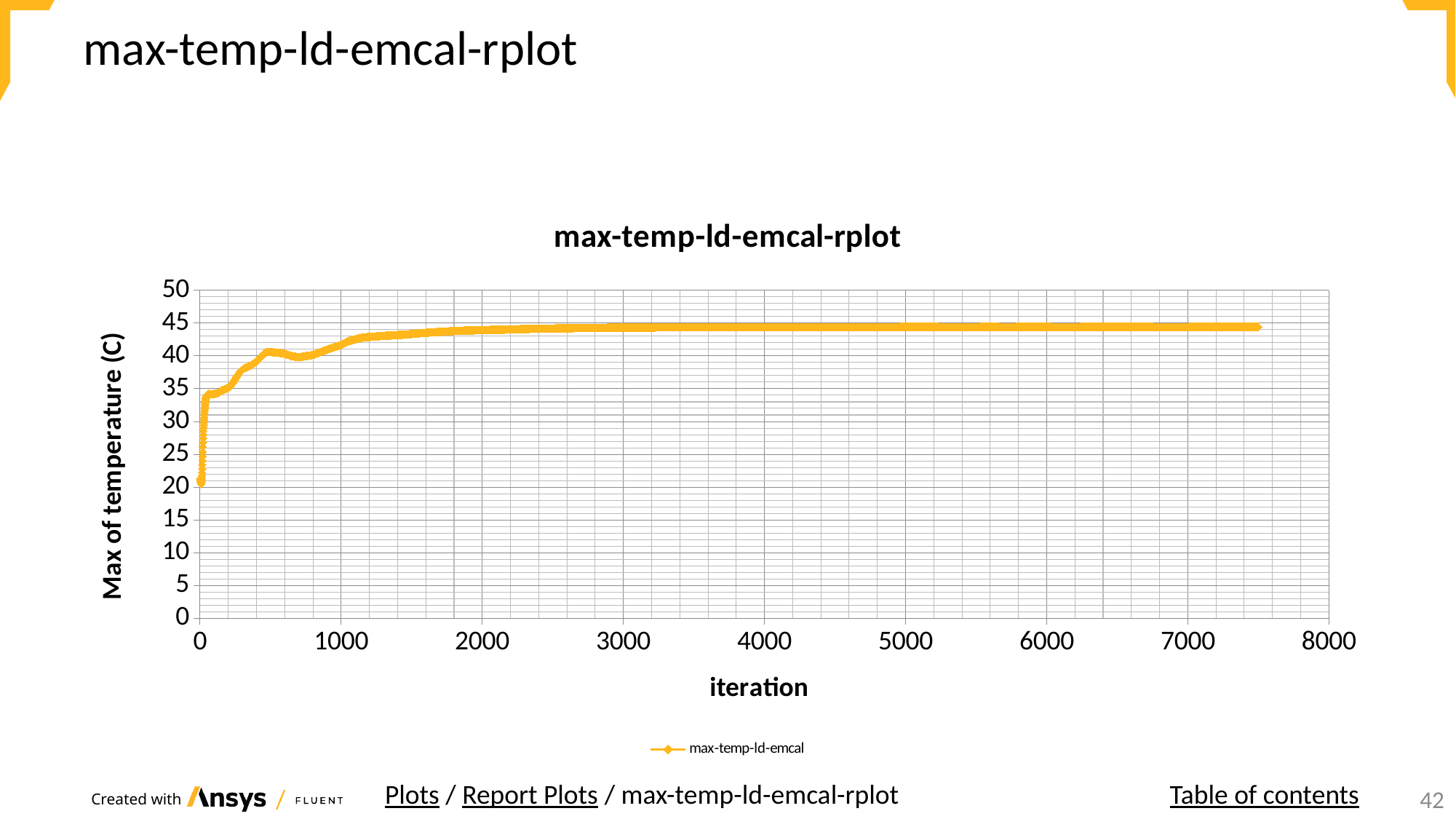
What kind of chart is shown on the slide? line chart What is the label of the y axis? Max of temperature (C) How many series does the legend list? 1 Is the value for max-temp-ld-emcal at iteration 6000 greater or less than 50? less What is the title of the chart? max-temp-ld-emcal-rplot Which is larger, the value for max-temp-ld-emcal at iteration 0 or at iteration 7000? iteration 7000 Is the value for max-temp-ld-emcal at iteration 0 greater or less than 25? less Is the value for max-temp-ld-emcal at iteration 1000 greater or less than 30? greater Does the plotted value generally rise or fall as the iteration increases? rise